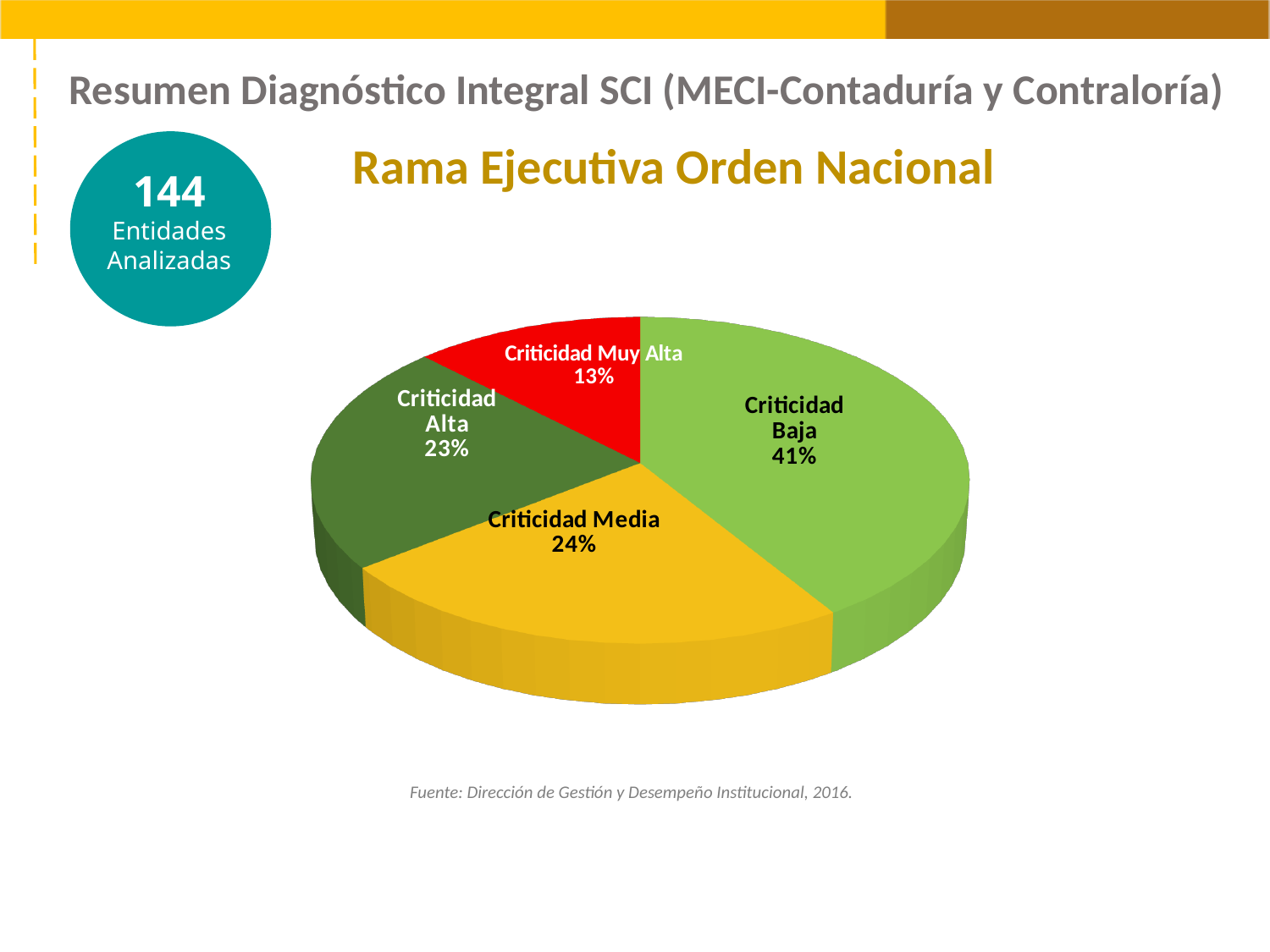
Which is larger, Criticidad Baja or Criticidad Media? Criticidad Baja Which category has the largest slice of the pie? Criticidad Baja What is the value shown for Criticidad Media? 24% What kind of chart is shown on the slide? Pie chart What colour is the Criticidad Muy Alta slice? Red What is the difference in percentage points between Criticidad Media and Criticidad Alta? 1 What is the value shown for Criticidad Muy Alta? 13% How many categories are shown in the pie chart? 4 Which category has the smallest slice of the pie? Criticidad Muy Alta What is the value shown for Criticidad Alta? 23% What share of the pie does Criticidad Baja represent? 41% What is the difference in percentage points between Criticidad Baja and Criticidad Muy Alta? 28